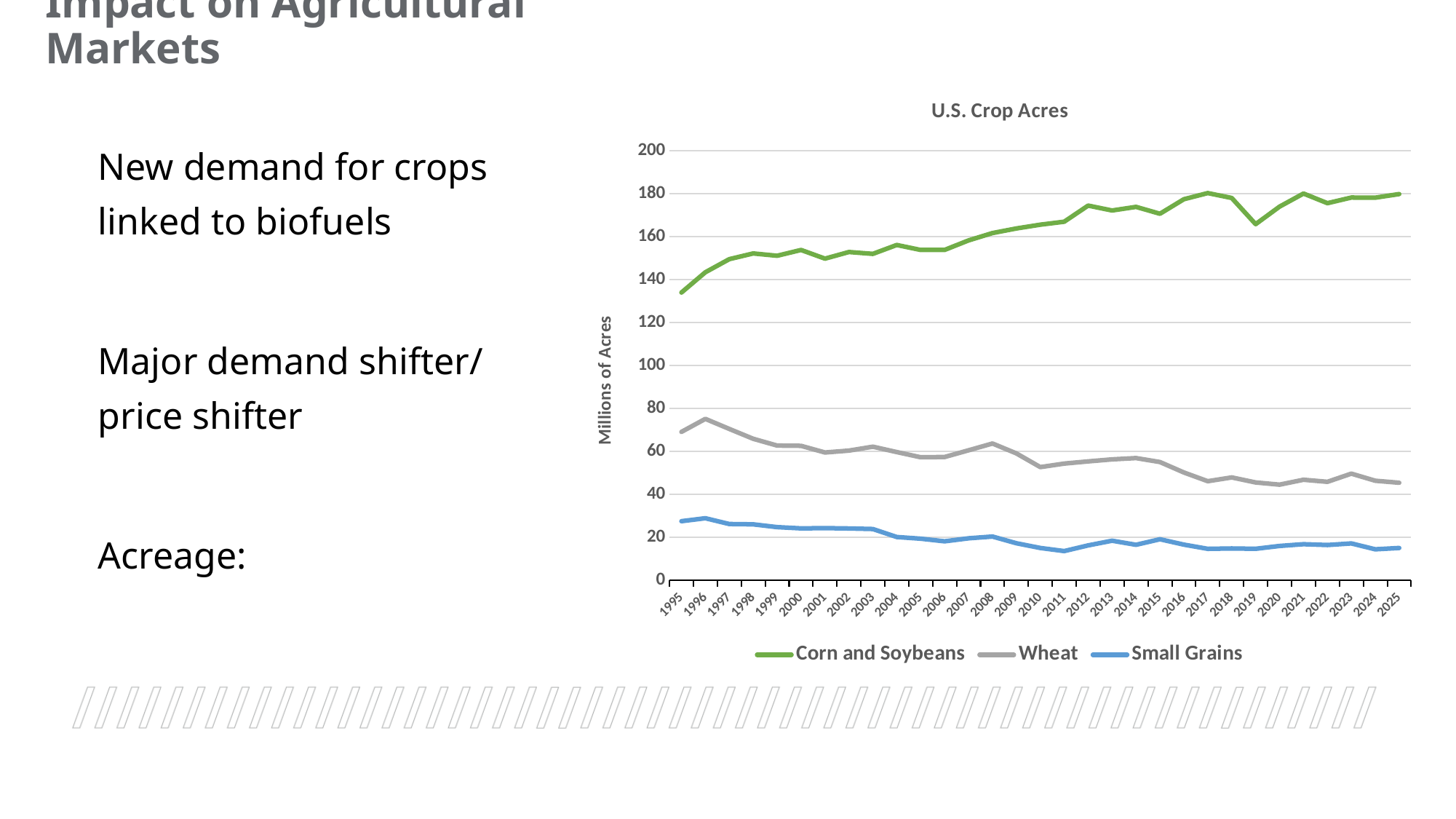
Does the Wheat line generally rise or fall from 1995 to 2025? Fall Which series has the lowest values throughout the chart? Small Grains In 2000, which is larger: Wheat or Small Grains? Wheat Which series has the highest values throughout the chart? Corn and Soybeans What is the title of the chart? U.S. Crop Acres How many years are plotted along the x axis of the U.S. Crop Acres chart? 31 Is the value for Wheat in 1996 greater or less than 60? greater Is the value for Corn and Soybeans in 1995 greater or less than 120? greater What is the label of the vertical axis? Millions of Acres How many series does the legend of the U.S. Crop Acres chart list? 3 What kind of chart is shown on the slide? Line chart Does the Corn and Soybeans line generally rise or fall from 1995 to 2025? Rise